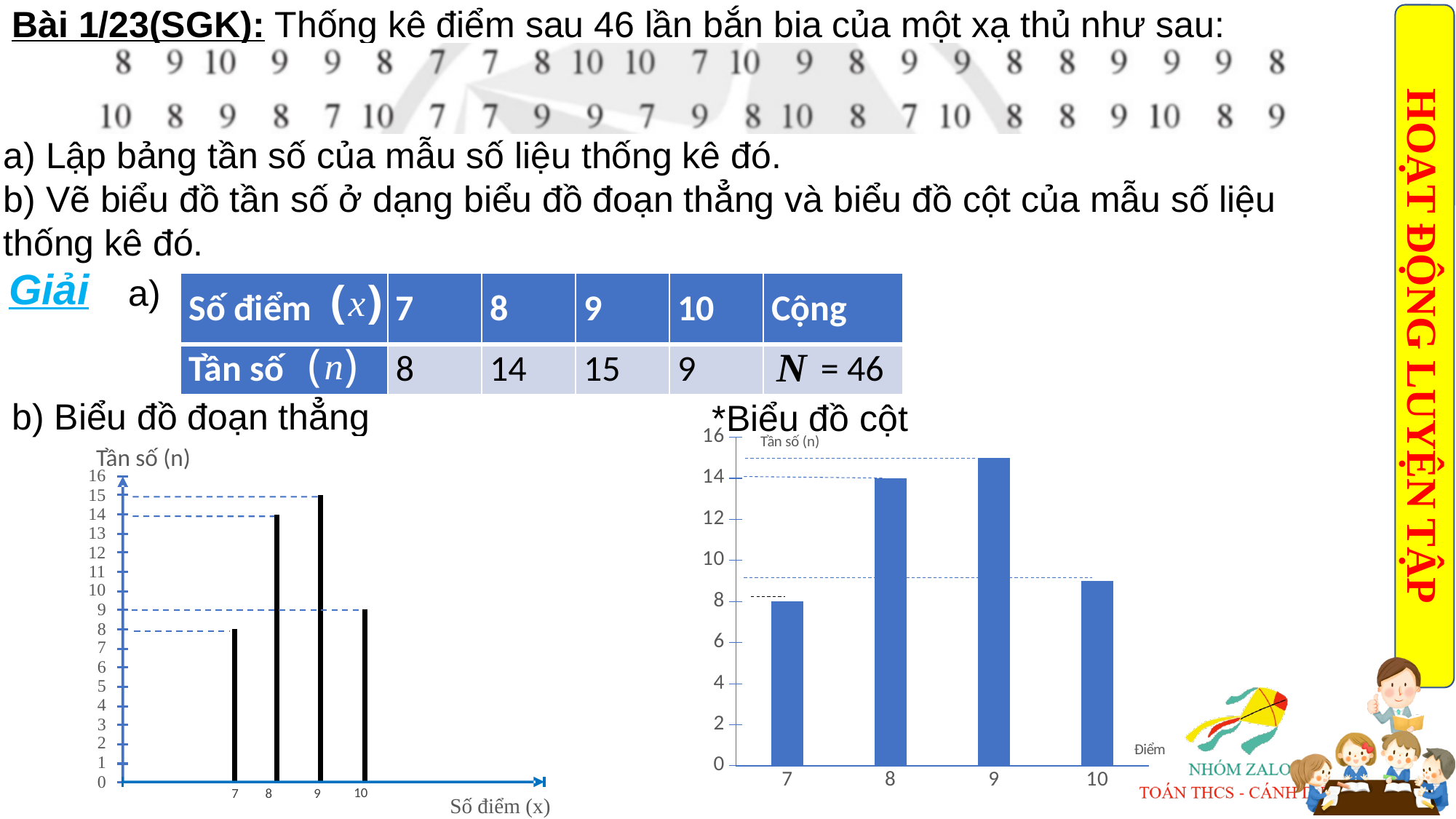
On the bar chart (Biểu đồ cột) on the right, what is the frequency (Tần số) for score 8? 14 On the bar chart (Biểu đồ cột) on the right, is the frequency for score 9 greater or less than 14? greater On the bar chart (Biểu đồ cột) on the right, which has the larger frequency, score 8 or score 10? 8 On the bar chart (Biểu đồ cột) on the right, what is the frequency (Tần số) for score 7? 8 On the bar chart (Biểu đồ cột) on the right, which score has the lowest frequency? 7 What kind of chart is the chart on the right of the slide (Biểu đồ cột)? bar chart On the bar chart (Biểu đồ cột) on the right, is the frequency for score 10 greater or less than 10? less On the line-segment chart (Biểu đồ đoạn thẳng) on the left, what is the frequency for score 9? 15 How many score categories are shown on the bar chart (Biểu đồ cột) on the right? 4 On the line-segment chart (Biểu đồ đoạn thẳng) on the left, what is the difference between the frequencies for score 9 and score 7? 7 On the line-segment chart (Biểu đồ đoạn thẳng) on the left, what is the frequency for score 10? 9 On the bar chart (Biểu đồ cột) on the right, which score has the highest frequency? 9